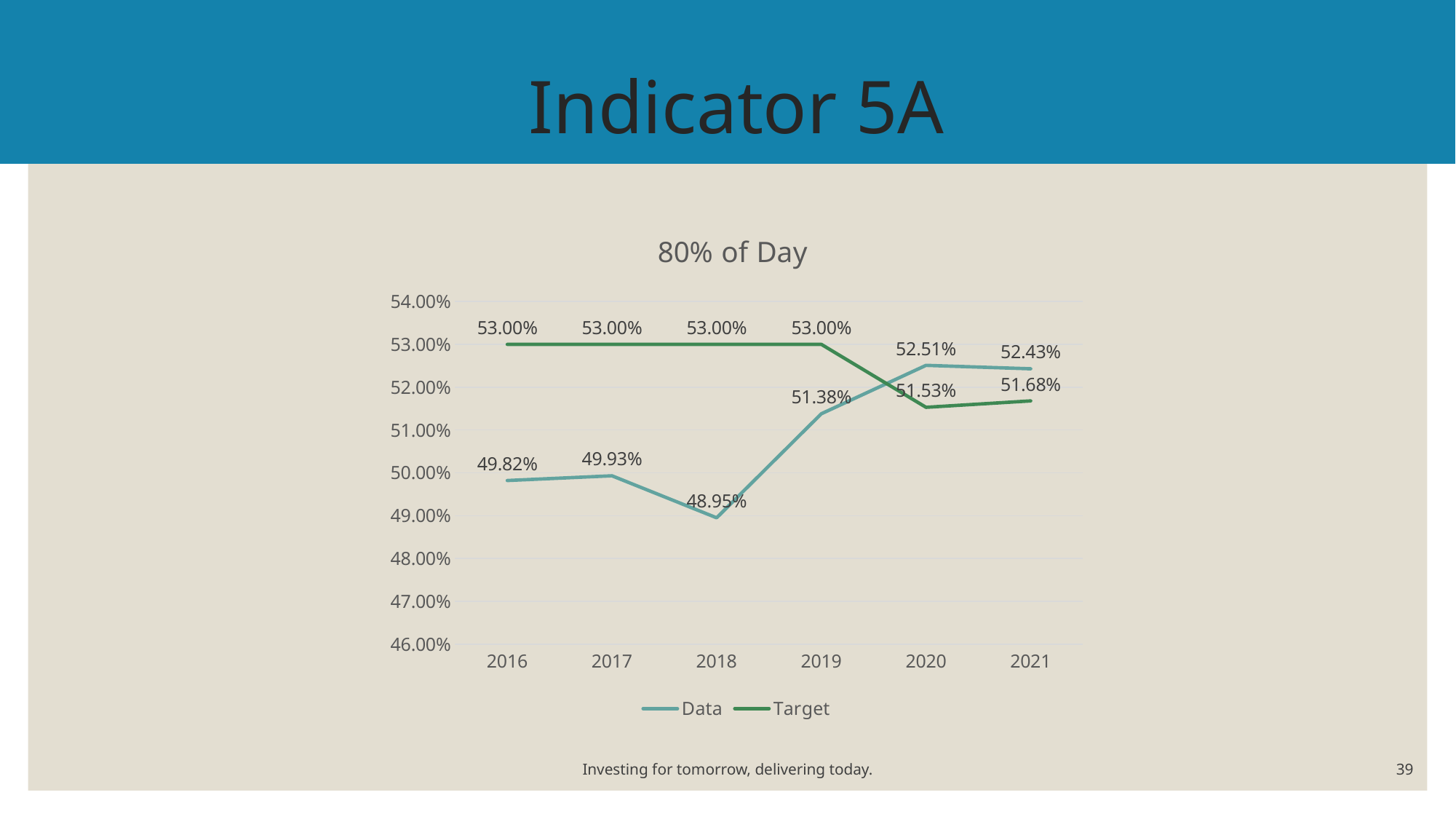
What is the Data value for 2021? 52.43% How many series does the legend list? 2 What kind of chart is shown? line chart Which is larger in 2020, the Data value or the Target value? Data How many years are shown on the x axis? 6 What is the title of the chart? 80% of Day What is the Data value for 2018? 48.95% In which year is the Data series at its lowest? 2018 What is the Target value for 2020? 51.53% In which year is the Data series at its highest? 2020 What is the difference between the Target and Data values in 2016? 3.18% Is the Data value for 2019 greater or less than 51.00%? greater